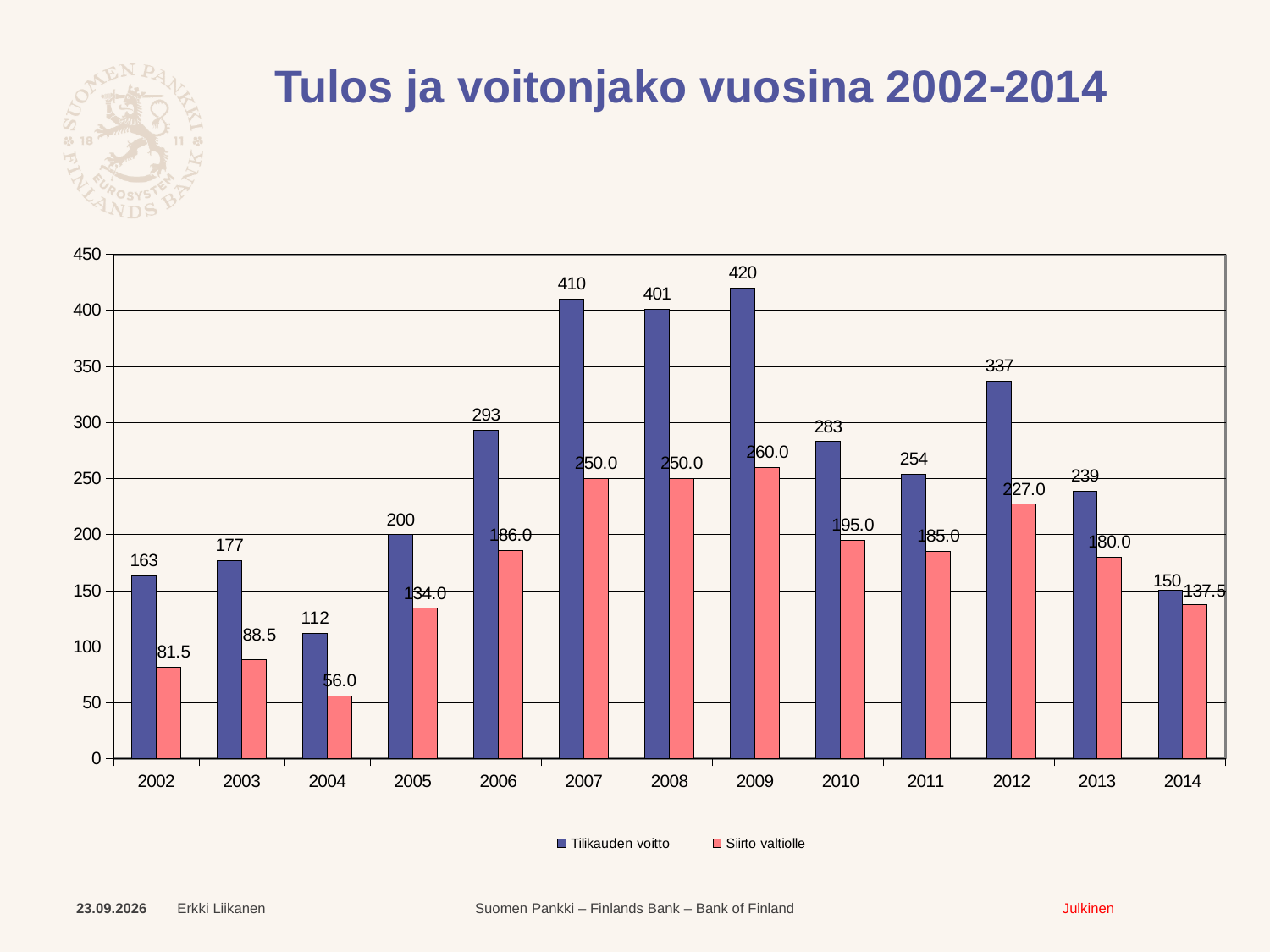
What kind of chart is shown on the slide? bar chart How many series does the legend list? 2 What is the Tilikauden voitto value for 2009? 420 What is the Siirto valtiolle value for 2005? 134.0 How many years are shown on the x axis? 13 What is the Siirto valtiolle value for 2014? 137.5 Is the Tilikauden voitto value for 2006 greater or less than 250? greater Which is larger: Tilikauden voitto in 2007 or in 2008? 2007 What is the difference between Tilikauden voitto and Siirto valtiolle in 2012? 110 Which year has the highest Tilikauden voitto? 2009 What is the title of the slide? Tulos ja voitonjako vuosina 2002-2014 Which year has the lowest Siirto valtiolle? 2004